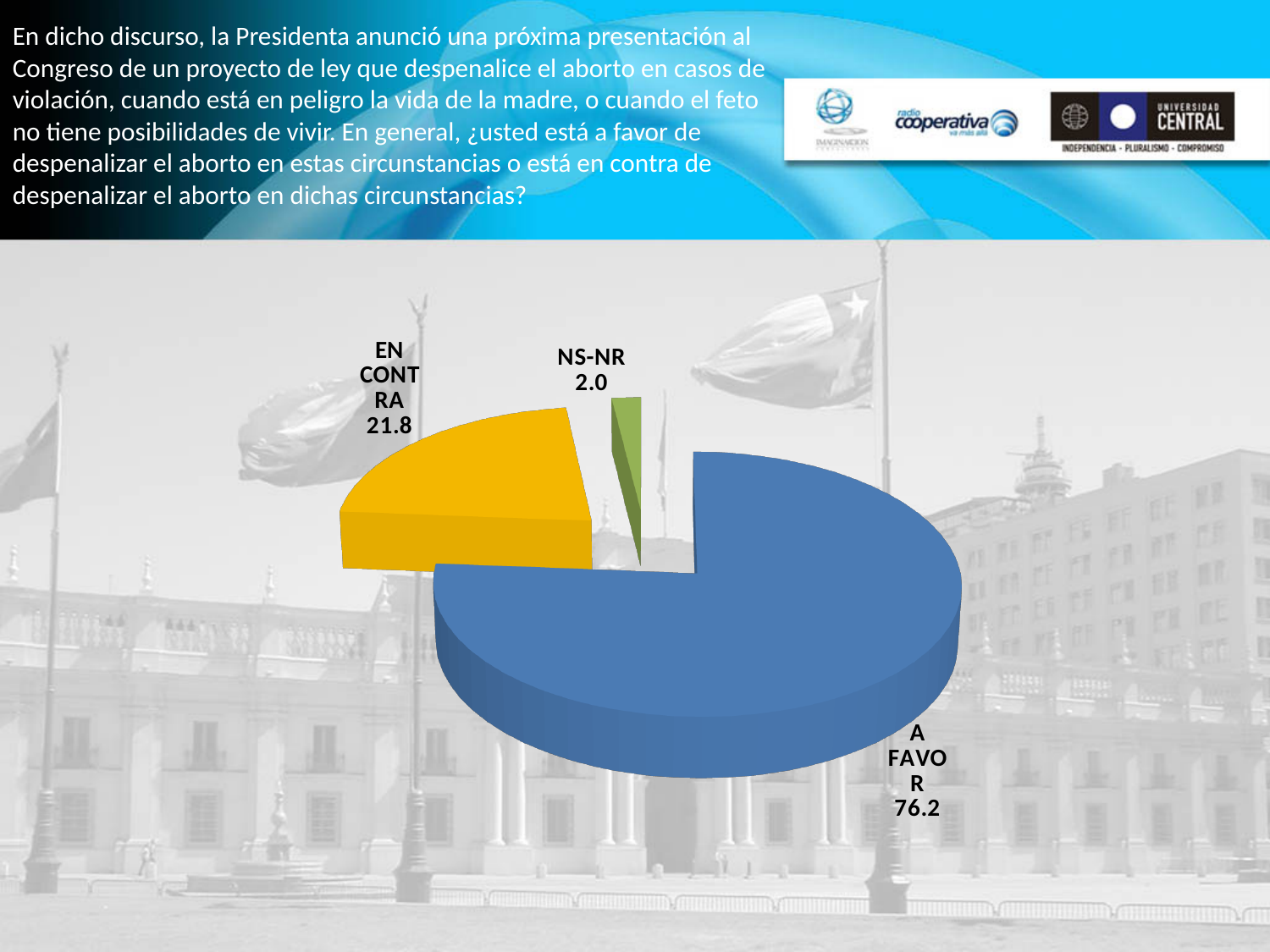
Which category has the smallest slice? NS-NR What is the difference between the values for A FAVOR and EN CONTRA? 54.4 What is the difference between the values for EN CONTRA and NS-NR? 19.8 What is the value for EN CONTRA? 21.8 Which is larger, EN CONTRA or NS-NR? EN CONTRA What is the value for A FAVOR? 76.2 What colour is the A FAVOR slice? Blue How many slices does the pie chart have? 3 What is the value for NS-NR? 2.0 Which category has the largest slice? A FAVOR What kind of chart is shown on the slide? Pie chart What colour is the EN CONTRA slice? Yellow